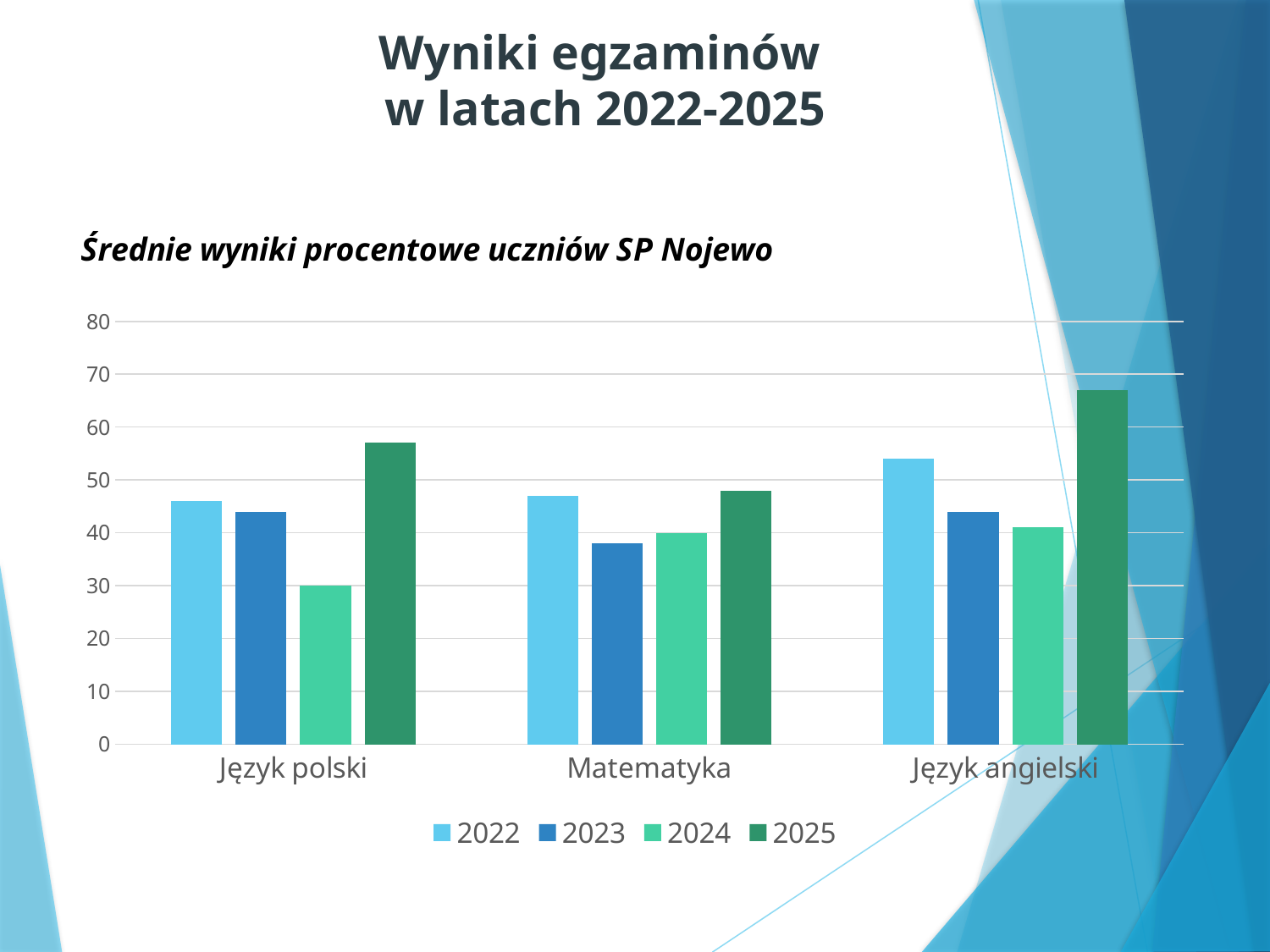
Which is larger: the 2022 value for Język angielski or the 2022 value for Język polski? Język angielski What kind of chart is shown on the slide? bar chart How many subject categories are shown on the x axis? 3 Is the value for Matematyka in 2025 greater or less than 40? greater How many series does the legend list? 4 Which year has the highest value for Język angielski? 2025 Which year has the lowest value for Matematyka? 2023 Which is larger: the 2025 value for Język polski or the 2025 value for Matematyka? Język polski Is the value for Język polski in 2024 greater or less than 40? less Is the value for Język angielski in 2025 greater or less than 60? greater Which year has the lowest value for Język polski? 2024 What is the title of the chart? Średnie wyniki procentowe uczniów SP Nojewo